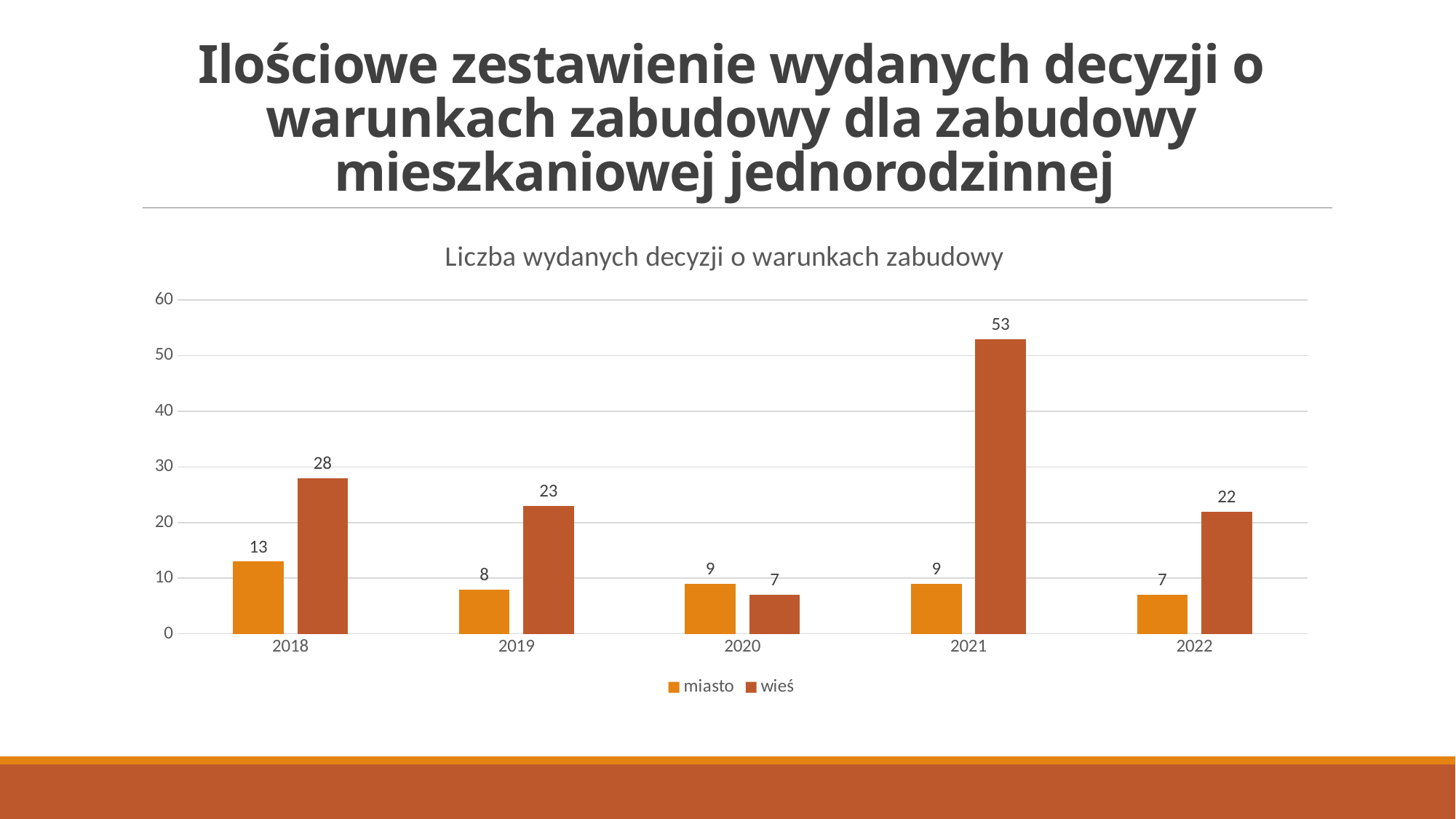
How many years are shown on the x axis? 5 What is the value for miasto in 2018? 13 In 2020, which is larger: miasto or wieś? miasto What is the title of the chart? Liczba wydanych decyzji o warunkach zabudowy What kind of chart is shown on the slide? bar chart How many series does the legend list? 2 Is the value for wieś in 2018 greater or less than 20? greater What is the difference between wieś and miasto in 2021? 44 Which year has the lowest value for miasto? 2022 What is the value for wieś in 2021? 53 Which year has the highest value for wieś? 2021 What is the value for wieś in 2020? 7